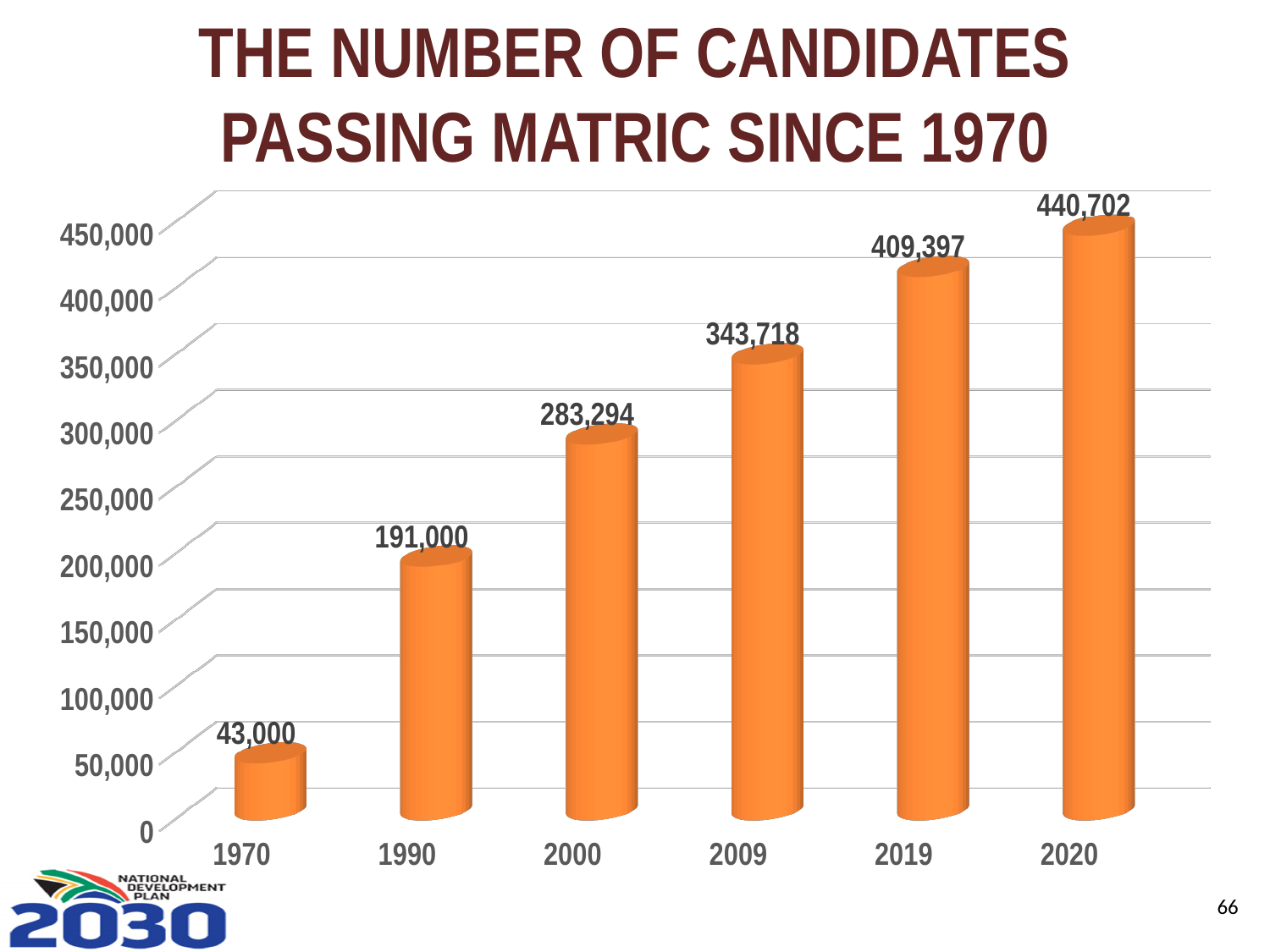
How many candidates passed matric in 1970? 43,000 Which is larger, the value for 2000 or the value for 2009? 2009 How many years are shown on the x axis? 6 What kind of chart is shown on the slide? bar chart Do the values rise or fall from 1970 to 2020? rise Is the value for 1990 greater or less than 200,000? less What is the difference between the values for 2020 and 2019? 31,305 Which year has the lowest number of candidates passing matric? 1970 What is the difference between the values for 2000 and 1990? 92,294 What is the value shown for 2019? 409,397 What is the value shown for 2009? 343,718 Which year has the highest number of candidates passing matric? 2020